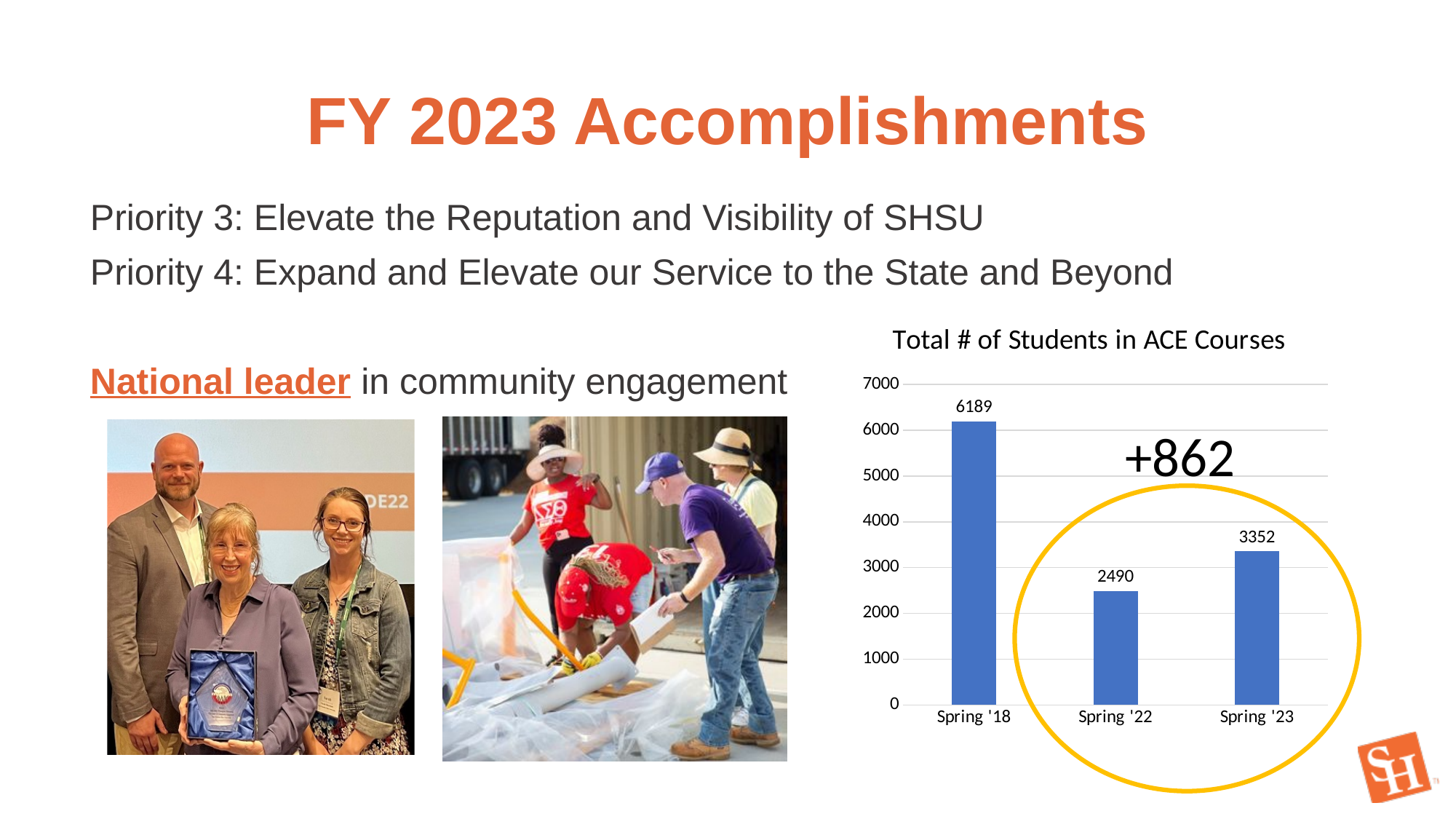
Which is larger, the number of students in Spring '22 or Spring '23? Spring '23 What is the total number of students in ACE courses for Spring '22? 2490 What type of chart is shown on the slide? bar chart What is the total number of students in ACE courses for Spring '23? 3352 What is the difference in the number of students between Spring '23 and Spring '22? 862 How many categories are shown on the x axis of the chart? 3 Which term has the highest number of students in ACE courses? Spring '18 Is the value for Spring '18 greater or less than 6000? greater What is the total number of students in ACE courses for Spring '18? 6189 What is the difference in the number of students between Spring '18 and Spring '23? 2837 What is the title of the chart on the slide? Total # of Students in ACE Courses Which term has the lowest number of students in ACE courses? Spring '22